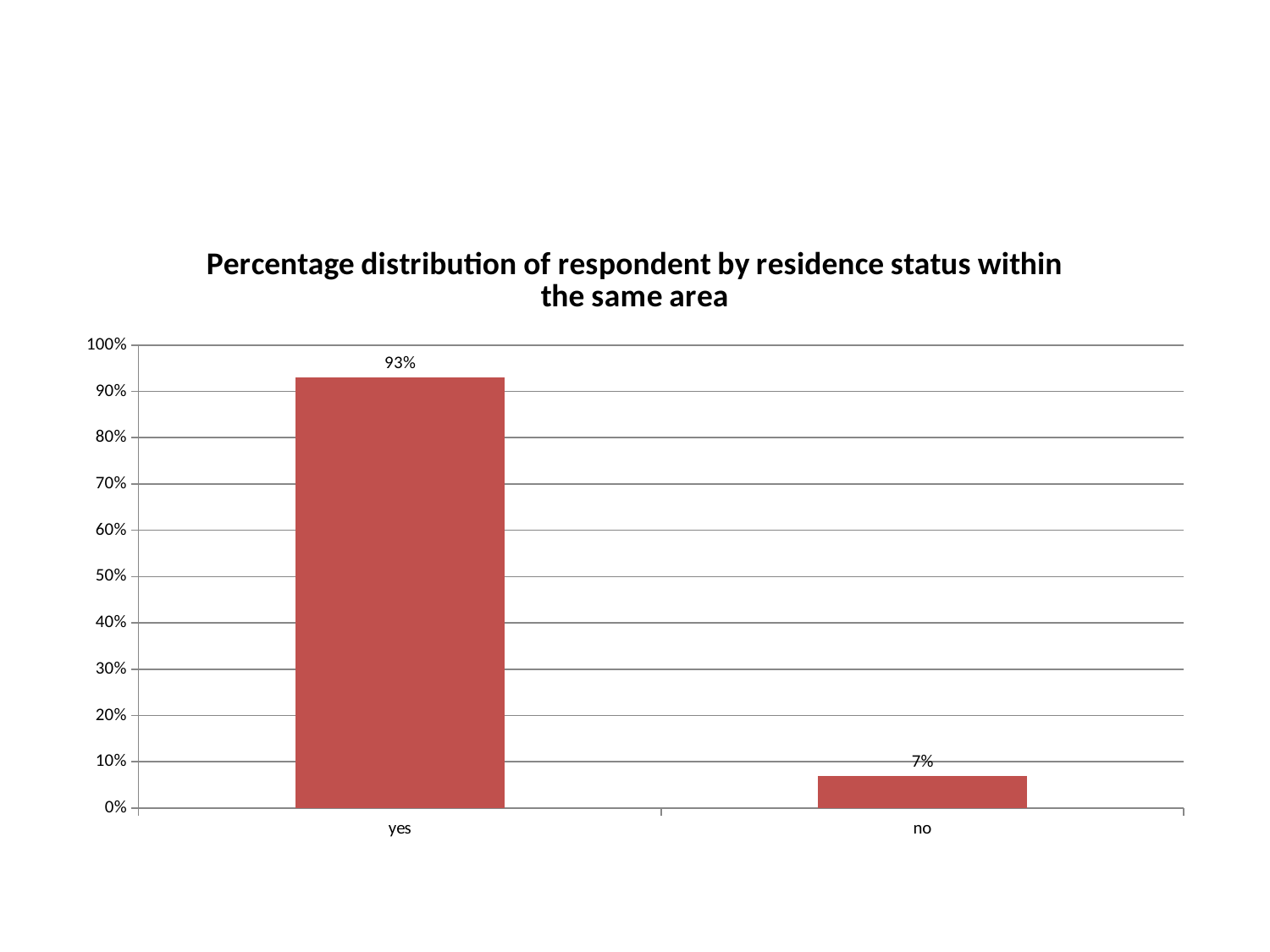
What is the value for "no"? 7% What kind of chart is shown on the slide? bar chart What is the title of the chart? Percentage distribution of respondent by residence status within the same area What is the value for "yes"? 93% How many categories are shown on the x axis? 2 Is the value for "no" greater or less than 10%? less Which category has the lowest value? no Is the value for "yes" greater or less than 90%? greater What is the difference between the values for "yes" and "no"? 86% Which category has the highest value? yes Which is larger, the value for "yes" or the value for "no"? yes What is the highest value shown on the y axis? 100%